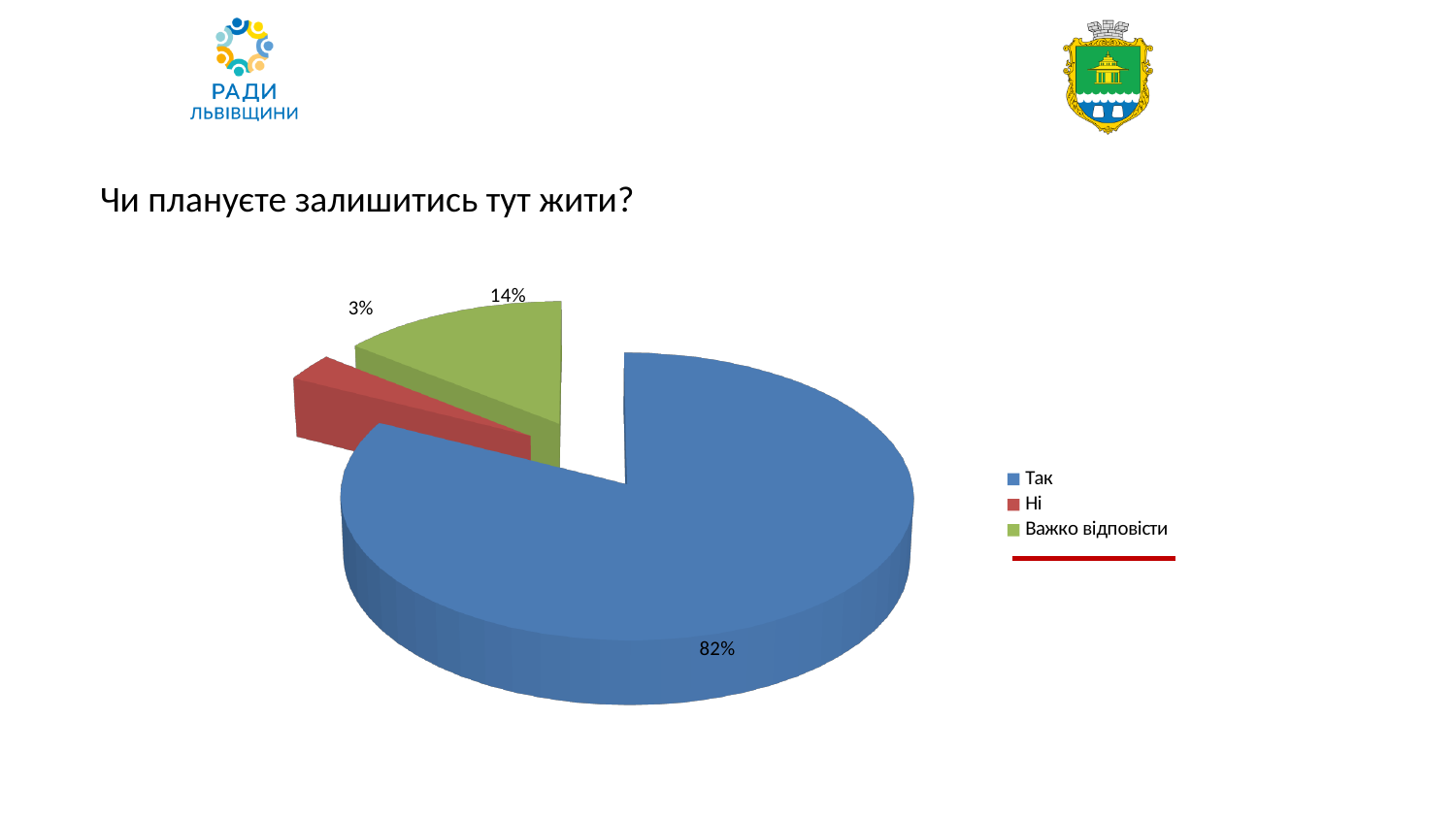
What share of the pie does "Важко відповісти" represent? 14% What is the difference in percentage points between "Важко відповісти" and "Ні"? 11 Which category has the largest slice of the pie? Так Which is larger, the share for "Ні" or the share for "Важко відповісти"? Важко відповісти Which category has the smallest slice of the pie? Ні What is the difference in percentage points between "Так" and "Важко відповісти"? 68 What question is the chart answering, according to the slide title? Чи плануєте залишитись тут жити? How many categories are shown in the pie chart? 3 What colour is the slice for "Ні"? Red What share of the pie does "Так" represent? 82% What share of the pie does "Ні" represent? 3% What kind of chart is shown on the slide? Pie chart